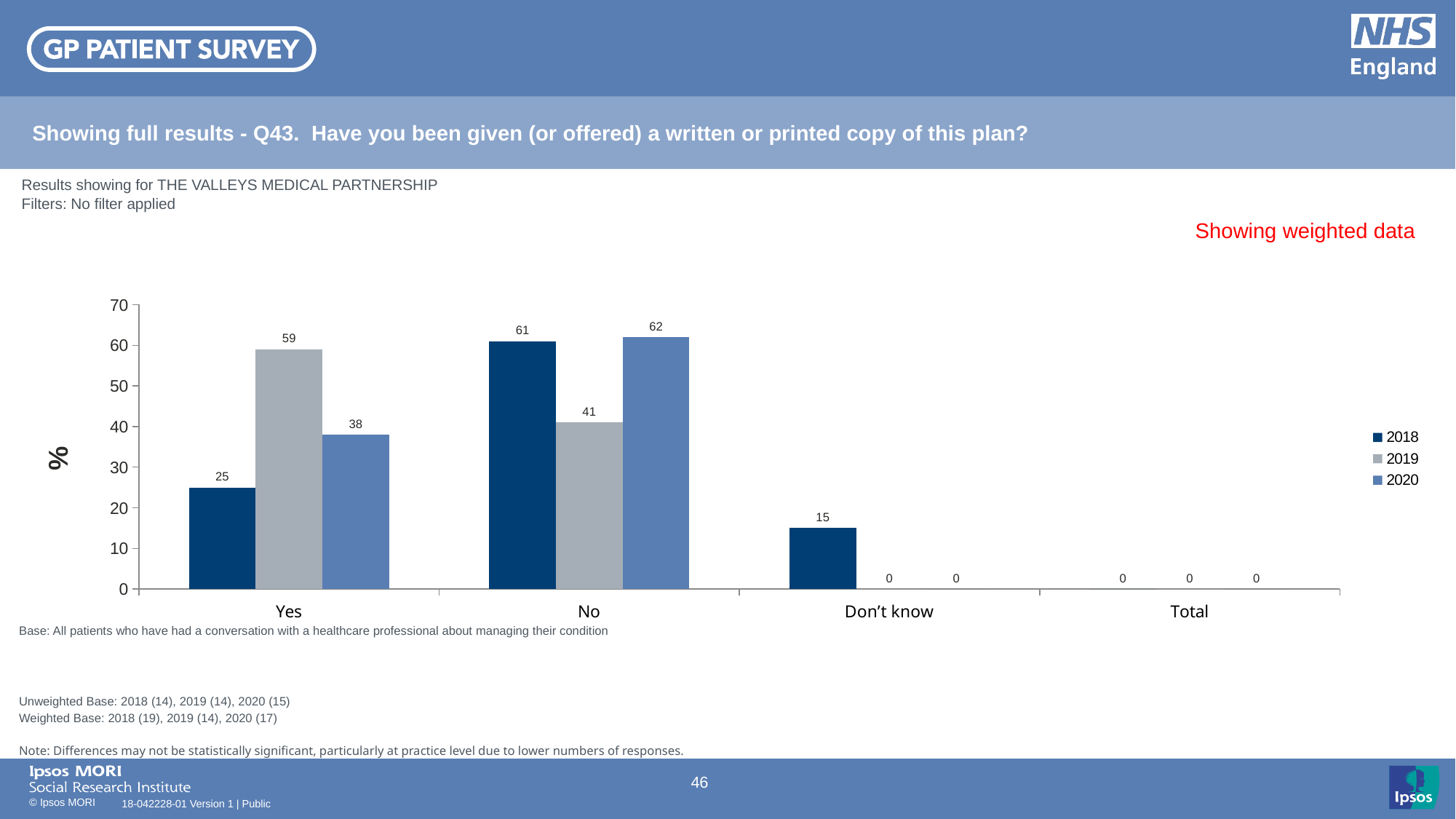
Which category has the highest value for the 2018 series? No What is the difference between the 'Yes' values for 2019 and 2020? 21 How many categories are shown on the x axis? 4 What is the value for 'Don't know' in 2018? 15 What is the value for 'No' in 2020? 62 What is the difference between the 'No' values for 2018 and 2019? 20 What kind of chart is shown on the slide? Bar chart What is the value for 'Yes' in 2018? 25 Which is larger: the 'Yes' value for 2020 or the 'No' value for 2020? No How many series does the legend list? 3 Which category has the highest value for the 2019 series? Yes What is the value for 'Yes' in 2019? 59